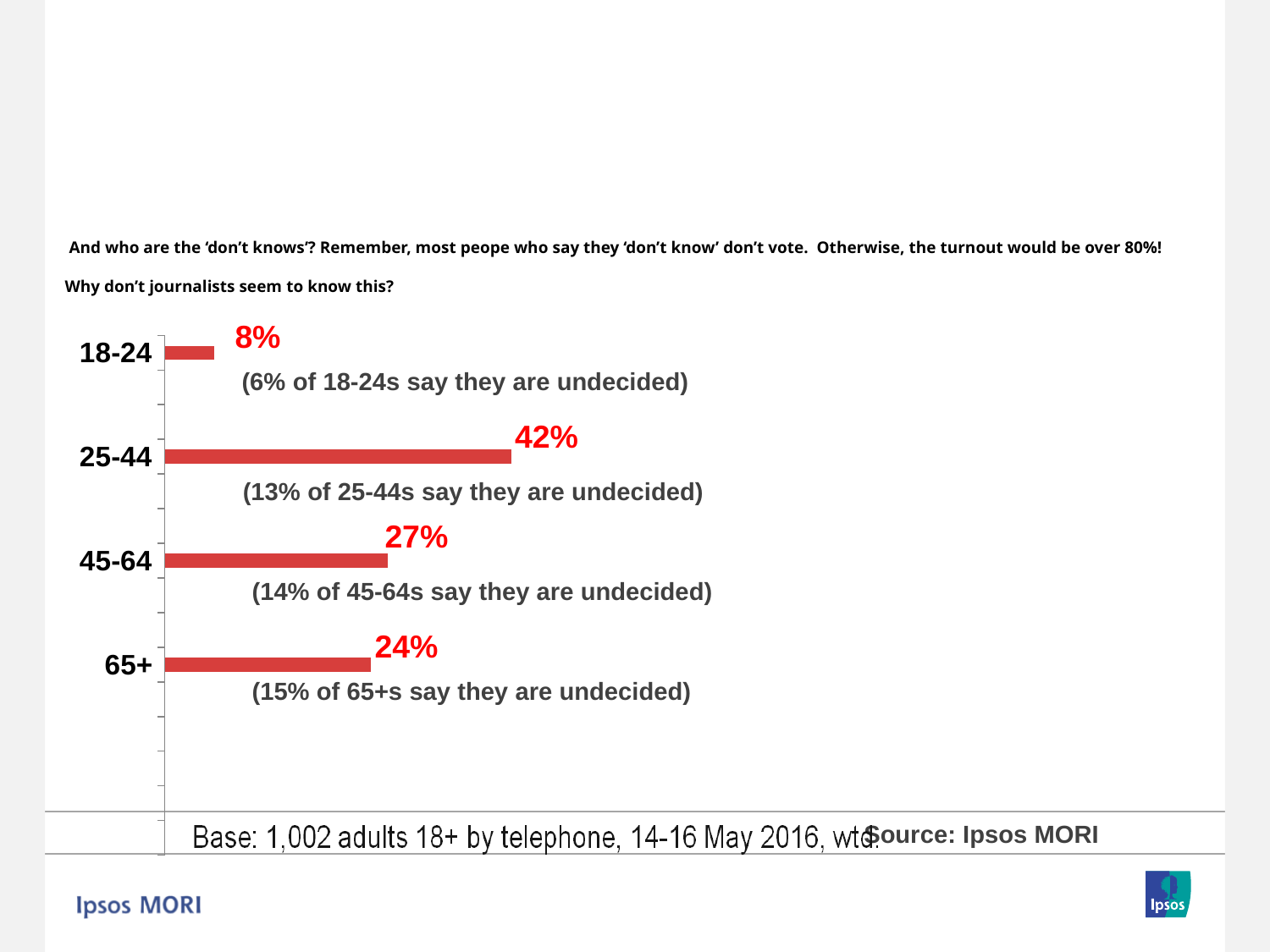
Which age group has the highest value? 25-44 How many age groups are shown in the chart? 4 What is the value for the 65+ age group? 24% What is the difference between the values for 45-64 and 65+? 3% What kind of chart is shown on the slide? Bar chart What is the value for the 18-24 age group? 8% What is the value for the 45-64 age group? 27% What is the value for the 25-44 age group? 42% According to the annotation, what percentage of 25-44s say they are undecided? 13% Which age group has the lowest value? 18-24 What is the difference between the values for 25-44 and 45-64? 15% Which is larger, the value for 45-64 or the value for 65+? 45-64